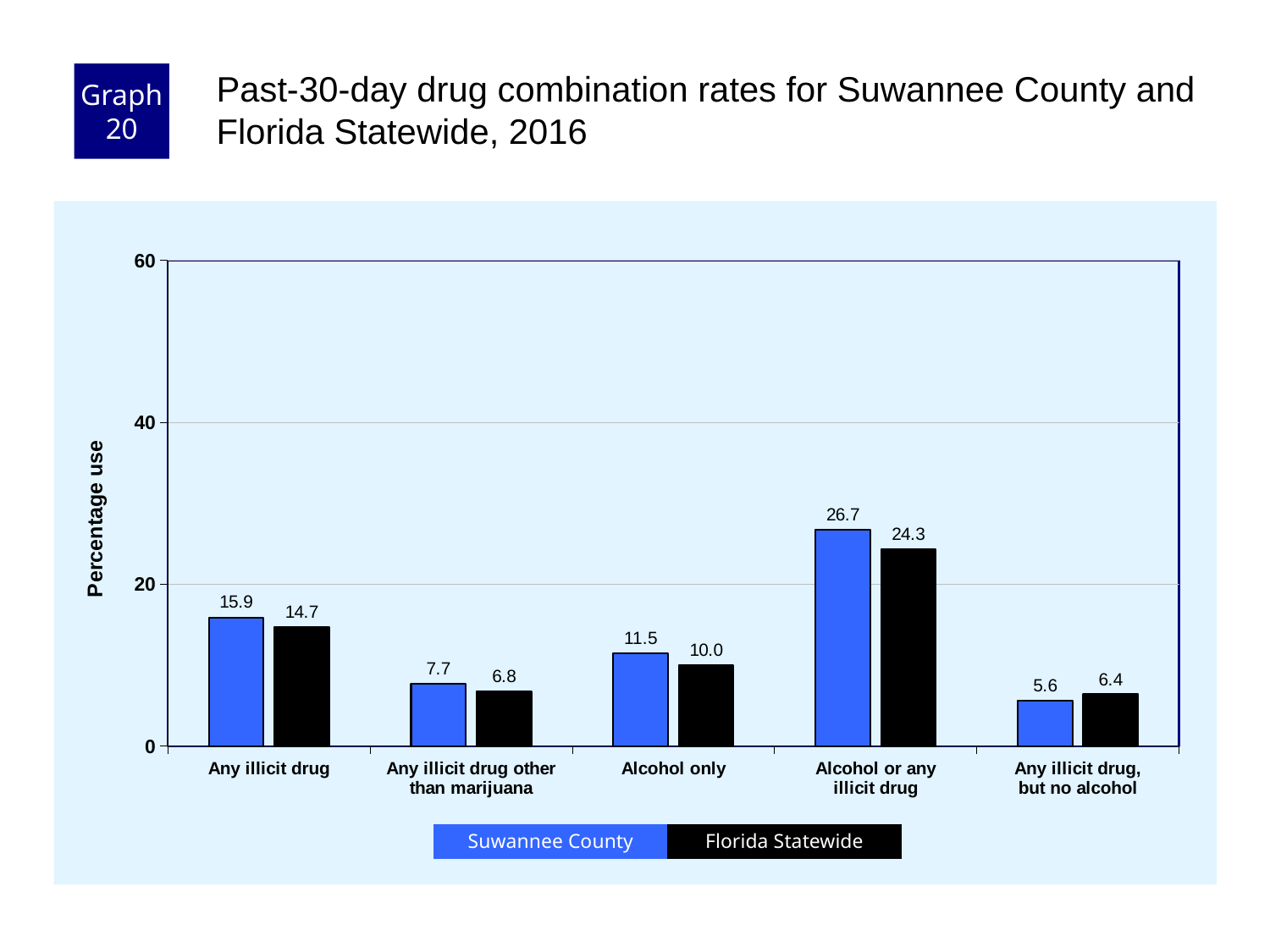
Which category has the lowest Florida Statewide value? Any illicit drug, but no alcohol How many categories are shown on the x axis? 5 For Any illicit drug, but no alcohol, which is larger: Suwannee County or Florida Statewide? Florida Statewide What kind of chart is shown on the slide? Bar chart What is the Florida Statewide value for Alcohol or any illicit drug? 24.3 How many series does the legend list? 2 What is the label of the y axis? Percentage use Is the Suwannee County value for Alcohol or any illicit drug greater or less than 20? greater What is the difference between the Suwannee County and Florida Statewide values for Any illicit drug? 1.2 What is the Suwannee County value for Alcohol only? 11.5 What is the Florida Statewide value for Any illicit drug other than marijuana? 6.8 Which category has the highest Suwannee County value? Alcohol or any illicit drug